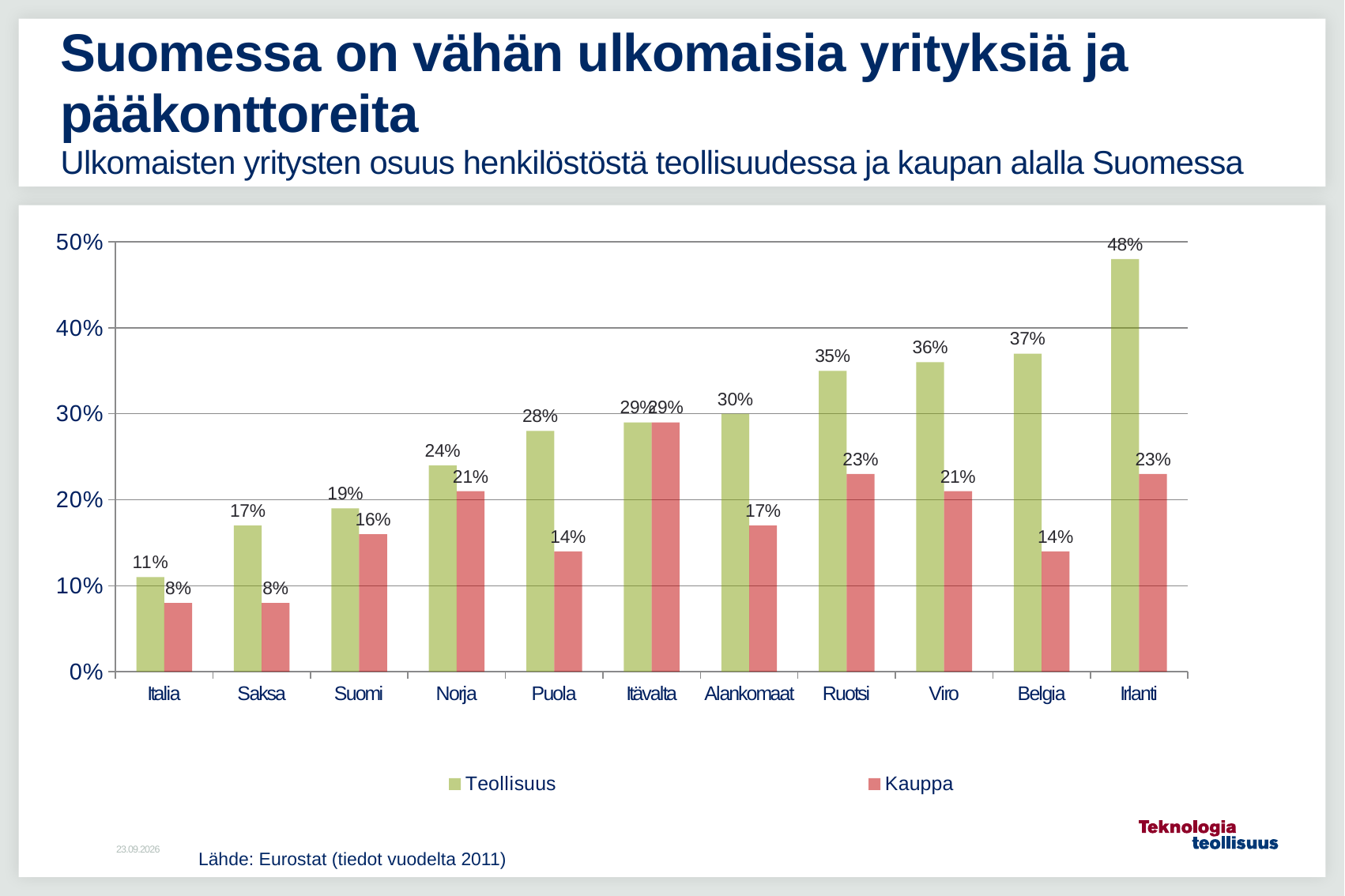
What is the difference between the Teollisuus and Kauppa values for Belgia? 23% What kind of chart is shown on the slide? Bar chart How many series does the legend list? 2 Which country has the lowest Teollisuus value? Italia Which country has the highest Teollisuus value? Irlanti Which colour represents the Kauppa series in the legend? Red What is the Kauppa value for Ruotsi? 23% What is the Teollisuus value for Suomi? 19% How many countries are shown on the x axis? 11 Is the Teollisuus value for Viro greater or less than 30%? greater Do the Teollisuus values rise or fall from Italia to Irlanti along the x axis? Rise Which is larger for Puola: the Teollisuus value or the Kauppa value? Teollisuus